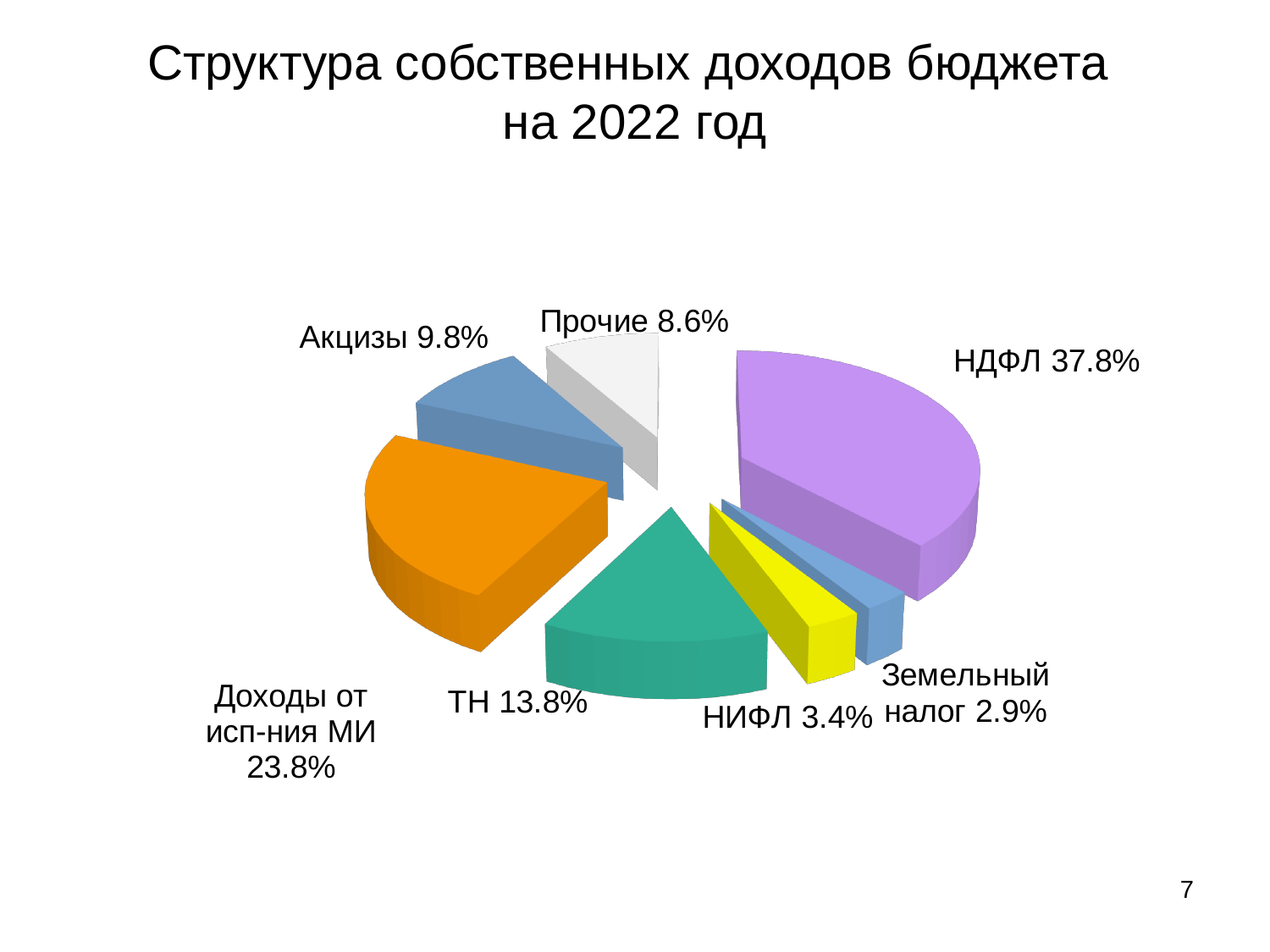
Which category has the smallest share of the pie? Земельный налог Which category has the largest share of the pie? НДФЛ What is the share of Доходы от исп-ния МИ? 23.8% How many slices does the pie chart have? 7 What kind of chart is shown on the slide? Pie chart What percentage is shown for ТН? 13.8% Which is larger, the share of Акцизы or the share of Прочие? Акцизы What is the share of Земельный налог? 2.9% What is the difference between the shares of НИФЛ and Земельный налог? 0.5 percentage points What share of the budget's own revenues does НДФЛ account for? 37.8% What is the difference between the shares of НДФЛ and Доходы от исп-ния МИ? 14 percentage points What is the title of the chart on the slide? Структура собственных доходов бюджета на 2022 год